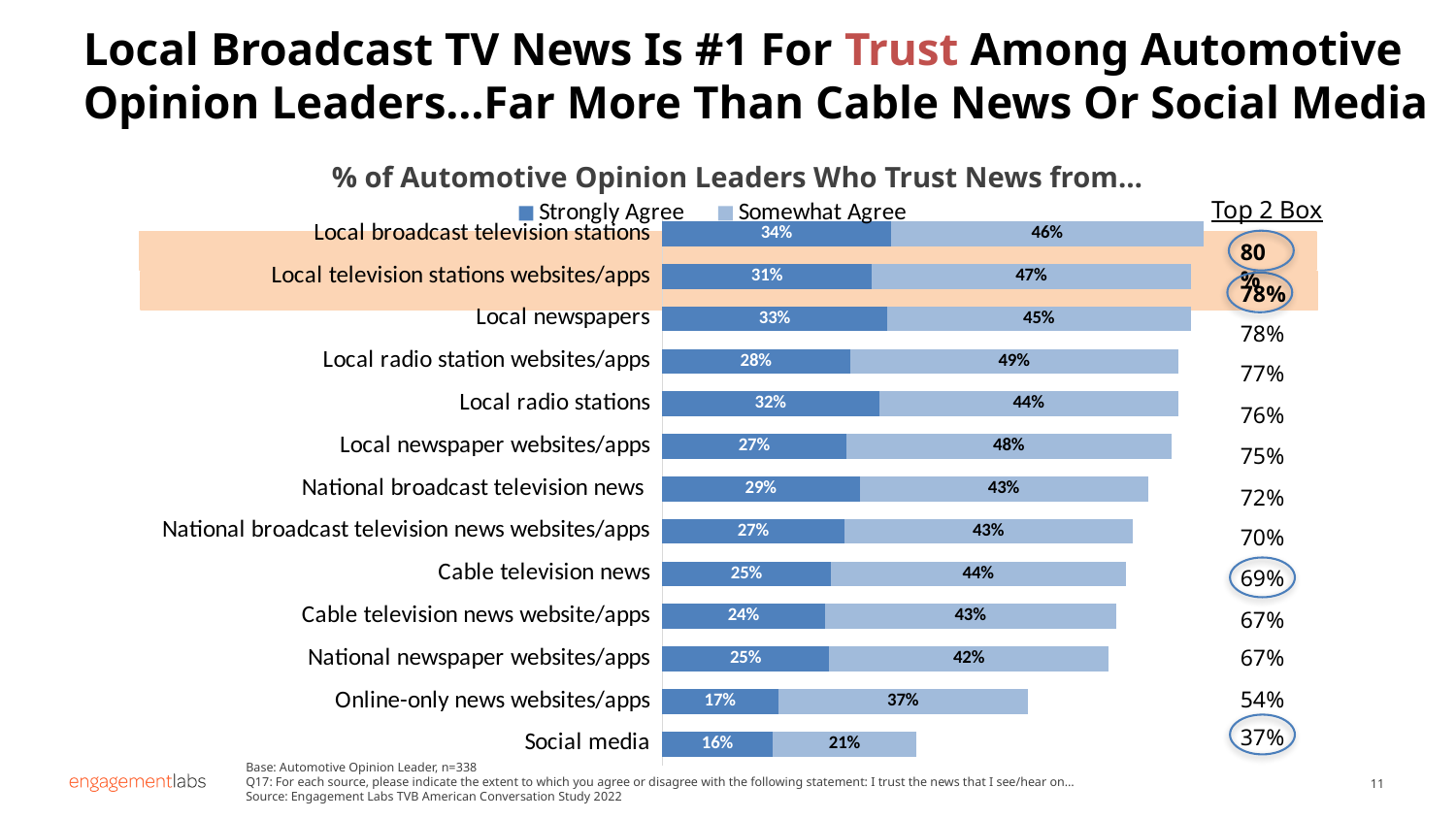
What is the Somewhat Agree value for local radio station websites/apps? 49% What percentage of automotive opinion leaders strongly agree that they trust news from local broadcast television stations? 34% How many series does the legend list? 2 What type of chart is shown on the slide? Stacked bar chart Which news source has the highest Strongly Agree percentage? Local broadcast television stations Which news source has the lowest Somewhat Agree percentage? Social media What is the Top 2 Box value for social media? 37% What is the total of the stacked bar for cable television news? 69% Which is larger: the Somewhat Agree value for local newspapers or for local radio stations? Local newspapers How many news sources are shown in the chart? 13 What are the two series named in the legend? Strongly Agree and Somewhat Agree What is the difference between the Strongly Agree values for local broadcast television stations and social media? 18 percentage points